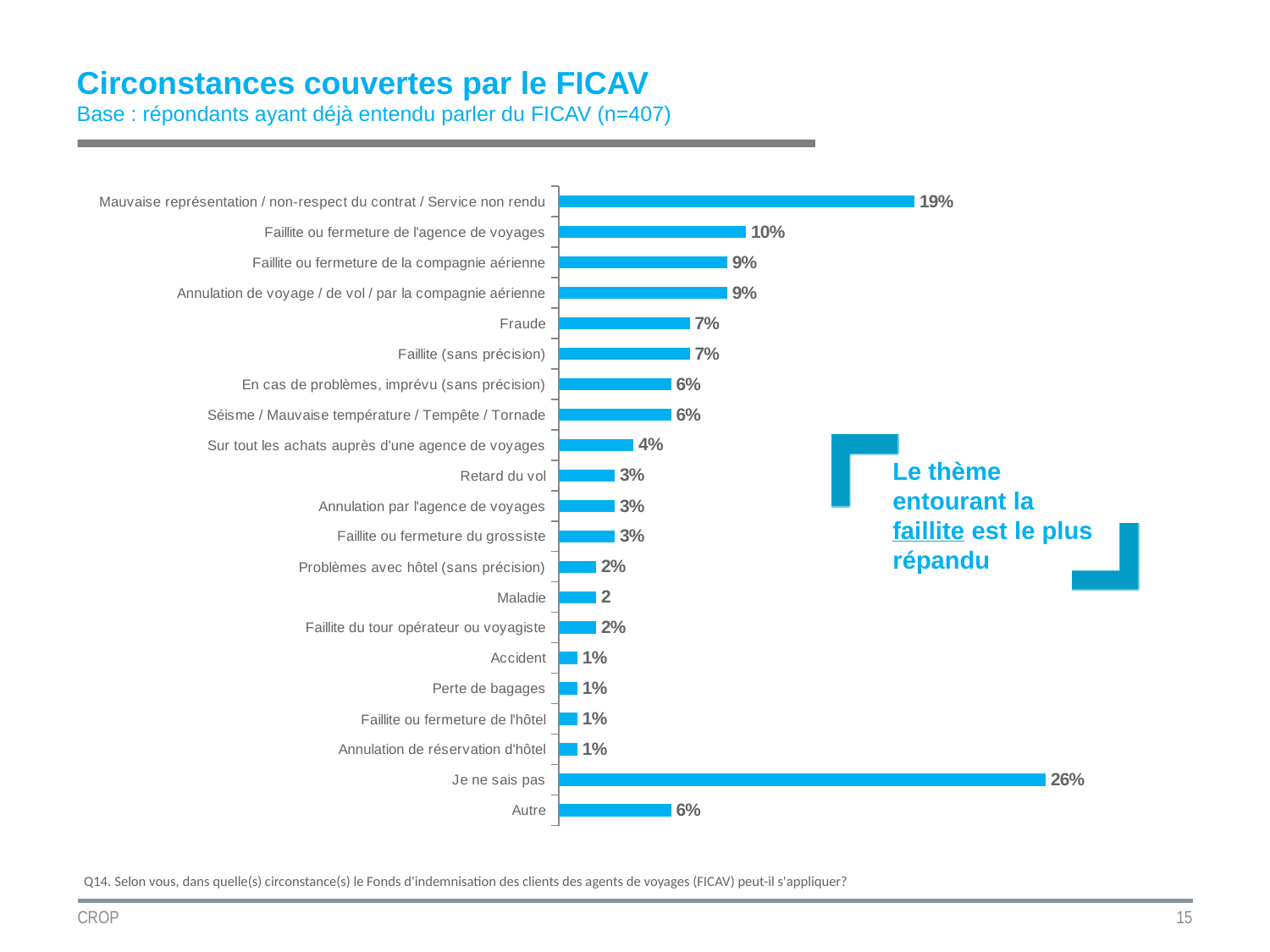
What is the value for "Sur tout les achats auprès d'une agence de voyages"? 4% What is the difference between the values for "Je ne sais pas" and "Mauvaise représentation / non-respect du contrat / Service non rendu"? 7% What type of chart is shown on the slide? bar chart What is the value for "Je ne sais pas"? 26% Which category has the highest value? Je ne sais pas Which is larger, the value for "Faillite ou fermeture de la compagnie aérienne" or the value for "Retard du vol"? Faillite ou fermeture de la compagnie aérienne What is the value for "Fraude"? 7% What is the lowest value shown on the chart? 1% What is the value for "Faillite ou fermeture de l'agence de voyages"? 10% What is the title of the slide containing the chart? Circonstances couvertes par le FICAV What is the value for "Mauvaise représentation / non-respect du contrat / Service non rendu"? 19% How many categories are shown on the chart? 21